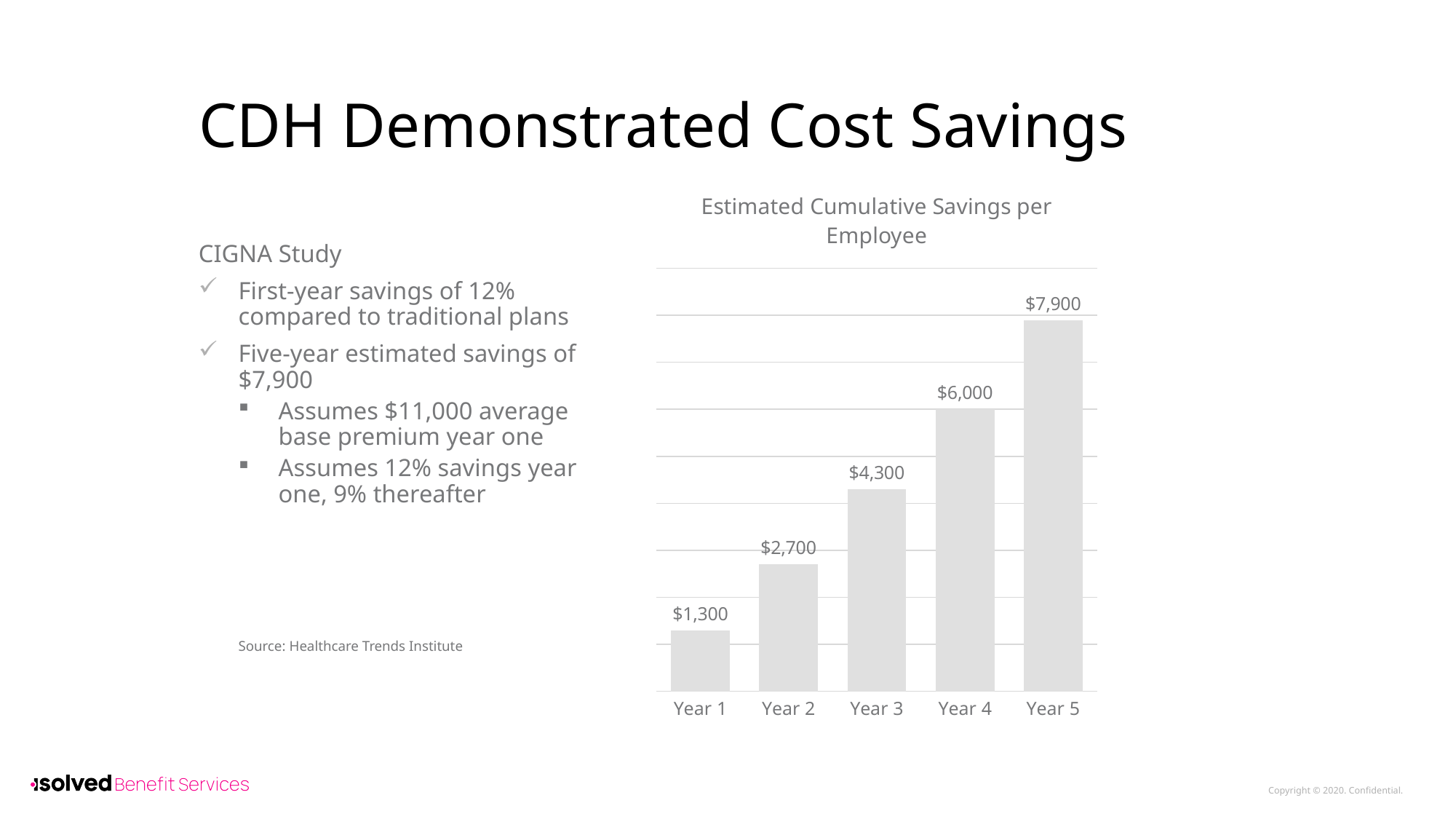
What is the title of the chart on the slide? Estimated Cumulative Savings per Employee What is the estimated cumulative savings per employee in Year 1? $1,300 How many years are shown on the x axis of the chart? 5 Which year has the lowest estimated cumulative savings per employee? Year 1 What is the estimated cumulative savings per employee in Year 5? $7,900 Do the cumulative savings values rise or fall from Year 1 to Year 5? Rise Which year has the highest estimated cumulative savings per employee? Year 5 Which is larger, the cumulative savings in Year 2 or in Year 3? Year 3 What kind of chart is used to show the estimated cumulative savings per employee? Bar chart What is the estimated cumulative savings per employee in Year 3? $4,300 What is the difference between the cumulative savings in Year 5 and Year 4? $1,900 What is the difference between the cumulative savings in Year 4 and Year 2? $3,300